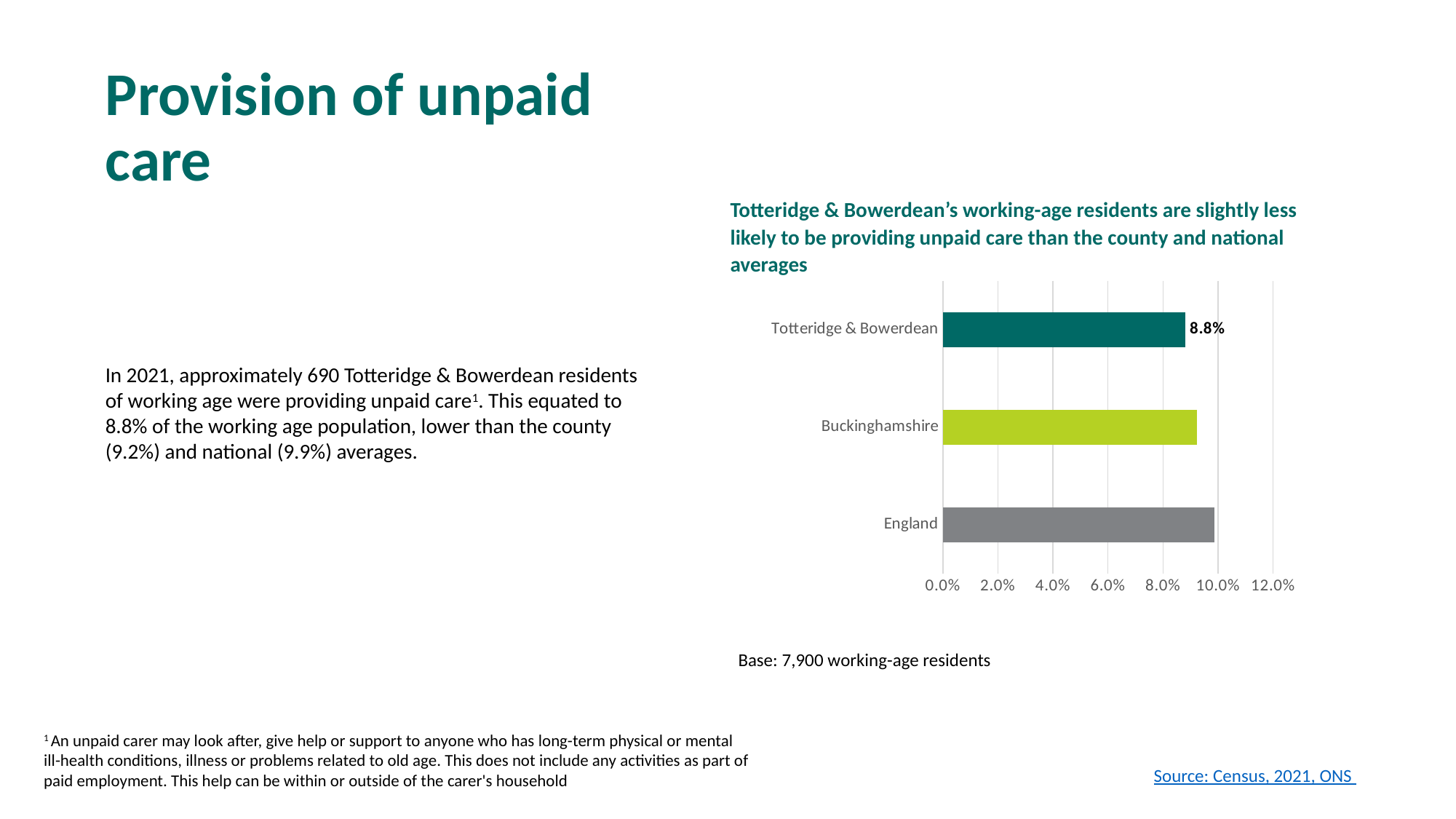
Which is larger, the value for Buckinghamshire or the value for England? England How many categories are shown in the chart? 3 What kind of chart is shown on the slide? Bar chart What is the value shown for Totteridge & Bowerdean? 8.8% Which category has the lowest value in the chart? Totteridge & Bowerdean Is the value for Totteridge & Bowerdean greater or less than 10.0%? less What is the highest value shown on the chart's x axis? 12.0% Which category has the highest value in the chart? England Is the value for England greater or less than 8.0%? greater Is the value for Buckinghamshire greater or less than 10.0%? less Which is larger, the value for Totteridge & Bowerdean or the value for England? England